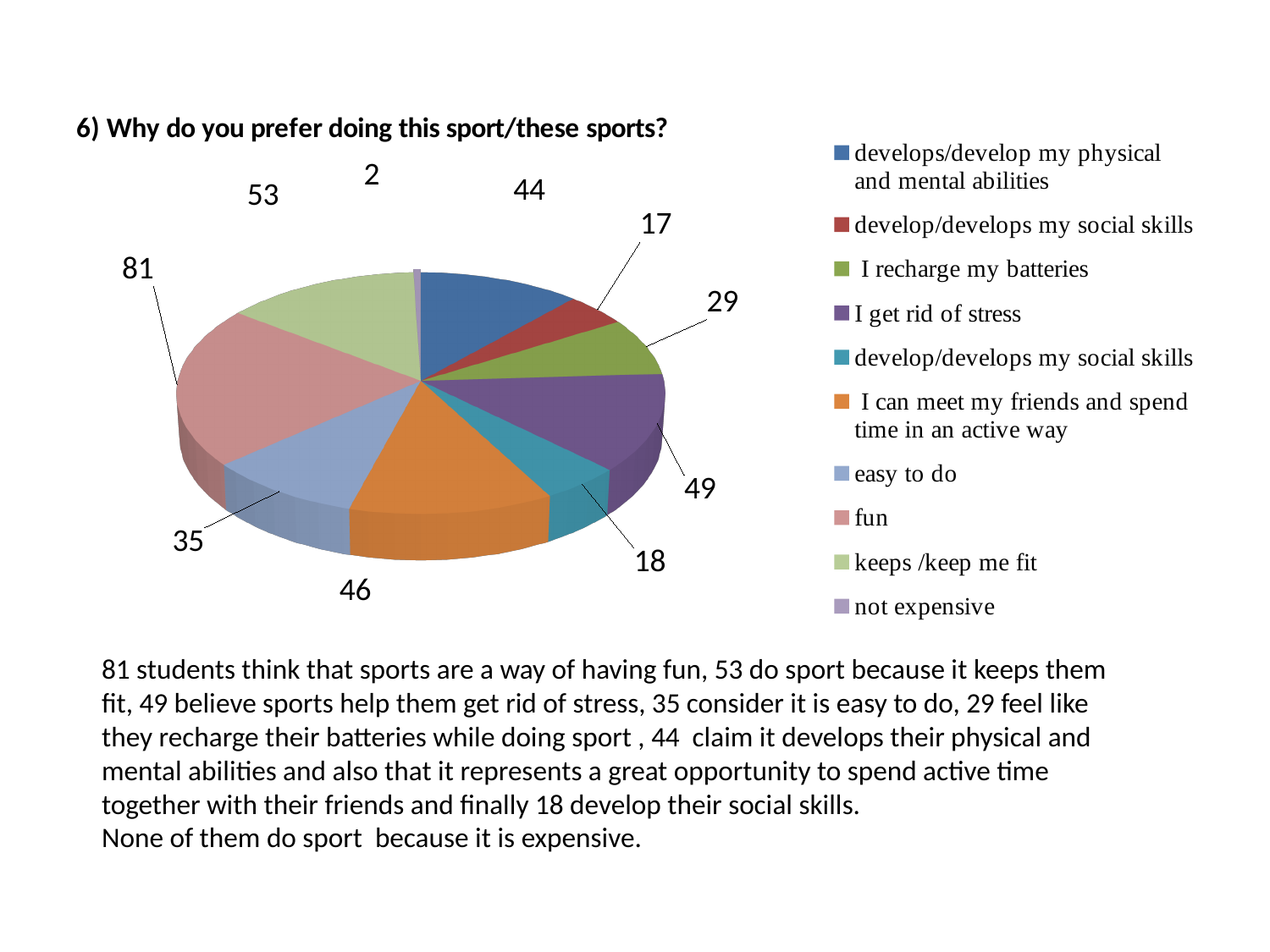
What is the value for the 'I get rid of stress' slice? 49 Which category has the largest slice in the pie chart? fun What is the difference between the 'fun' value and the 'keeps /keep me fit' value? 28 How many categories does the legend of the pie chart list? 10 What is the value for the 'easy to do' slice? 35 What is the value for the 'keeps /keep me fit' slice? 53 What is the value for the 'fun' slice? 81 Which is larger: 'I get rid of stress' or 'I can meet my friends and spend time in an active way'? I get rid of stress Which category has the smallest slice in the pie chart? not expensive What is the value for the 'I recharge my batteries' slice? 29 What kind of chart is shown on the slide? pie chart What is the value for the 'I can meet my friends and spend time in an active way' slice? 46